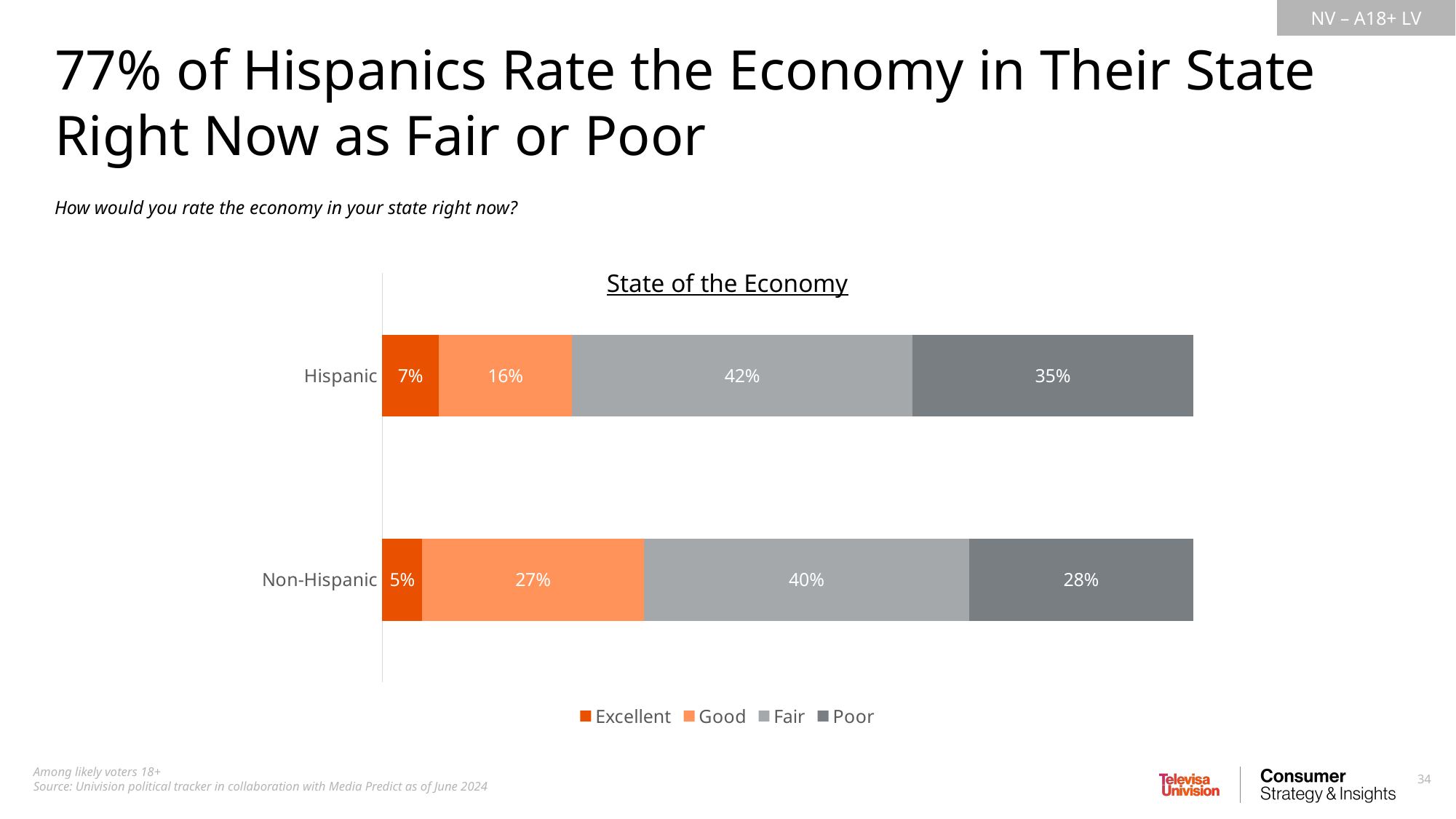
Which rating category has the largest share among Hispanics? Fair How many series does the legend list? 4 How many groups are shown on the chart? 2 What percentage of Non-Hispanics rate the economy in their state as Excellent? 5% What is the combined Fair and Poor share for Hispanics? 77% Which rating category has the smallest share among Non-Hispanics? Excellent What is the difference between the Poor share for Hispanics and the Poor share for Non-Hispanics? 7 percentage points What percentage of Non-Hispanics rate the economy in their state as Good? 27% What type of chart is shown on the slide? Stacked bar chart Which group has a larger Good share, Hispanic or Non-Hispanic? Non-Hispanic What percentage of Hispanics rate the economy in their state as Fair? 42% What percentage of Hispanics rate the economy in their state as Poor? 35%